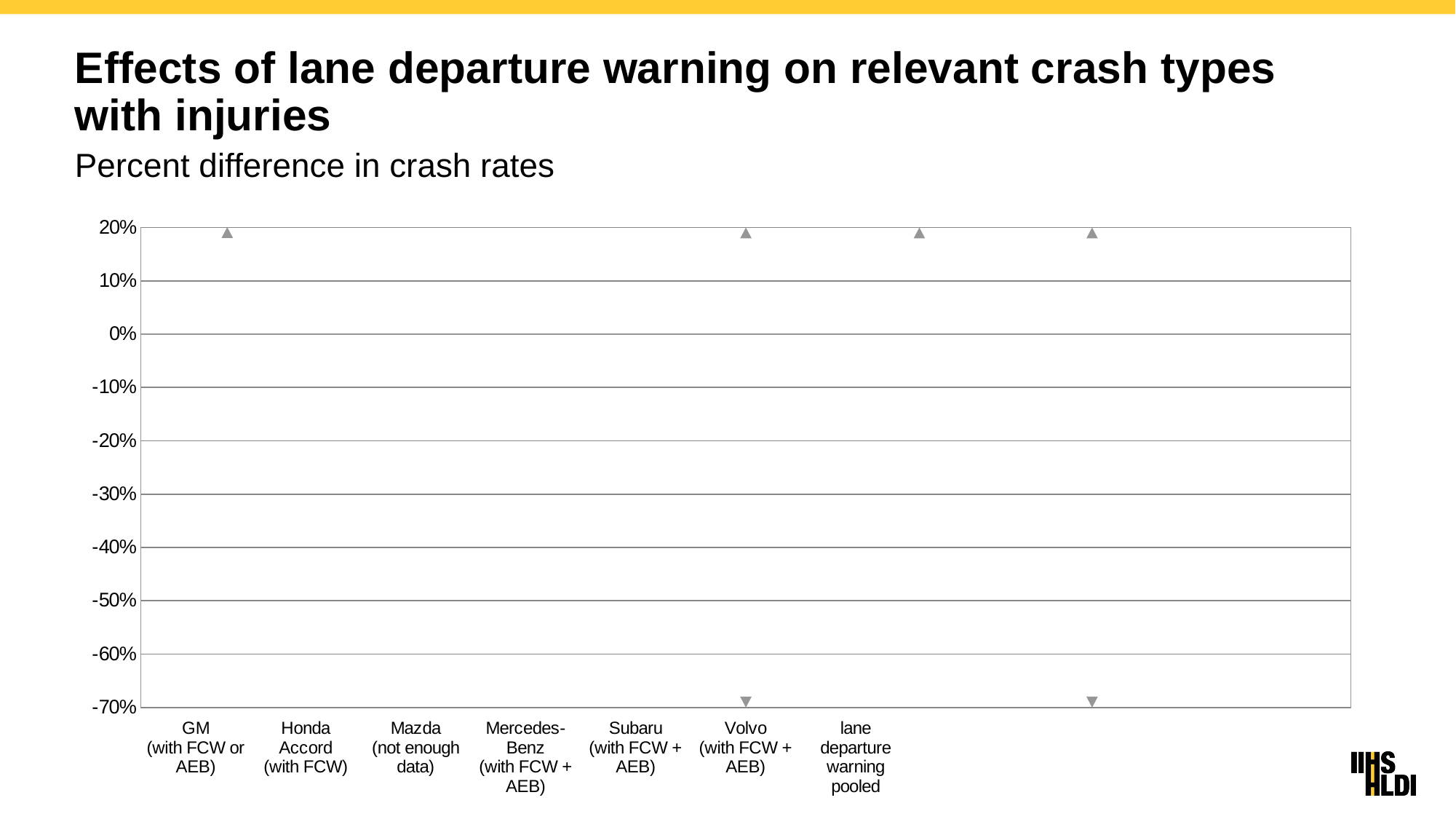
What is the lowest value shown on the y axis of the chart? -70% Which category on the x axis is labeled as having not enough data? Mazda What is the title of the slide containing the chart? Effects of lane departure warning on relevant crash types with injuries How many categories are shown along the x axis of the chart? 7 What is the highest value shown on the y axis of the chart? 20% What is the subtitle shown above the chart describing what is plotted? Percent difference in crash rates